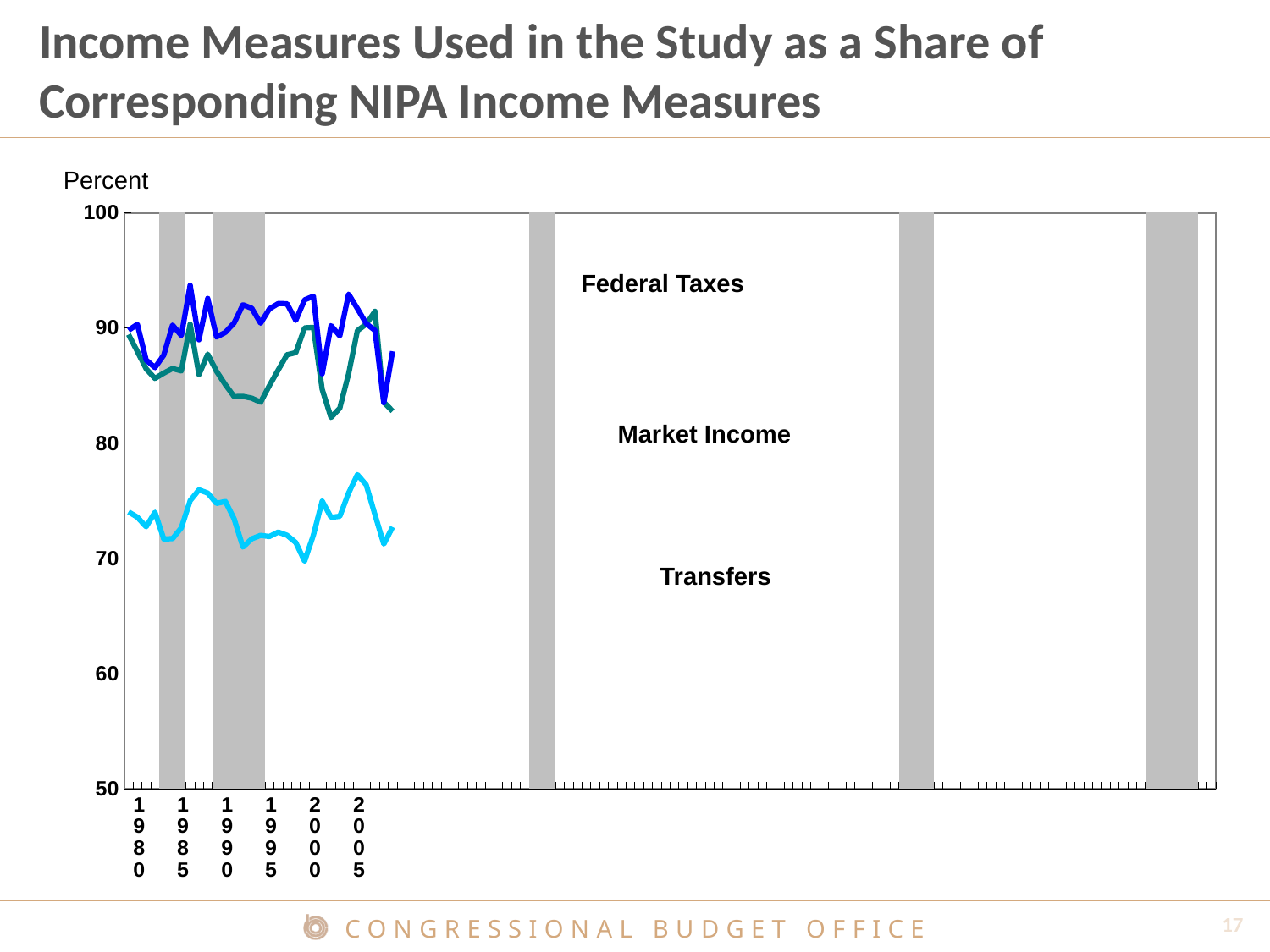
Around 1990, is the value for Market Income greater or less than 80? greater Around 1995, which is larger, the value for Federal Taxes or the value for Transfers? Federal Taxes Around 1980, is the value for Transfers greater or less than 70? greater Around 1995, is the value for Federal Taxes greater or less than 80? greater Which series has the lowest values throughout the period shown? Transfers How many year labels are shown along the horizontal axis? 6 What is the unit label shown above the vertical axis? Percent What kind of chart is shown on the slide? Line chart How many data series are plotted on the chart? 3 What are the names of the three series plotted on the chart? Federal Taxes, Market Income, Transfers